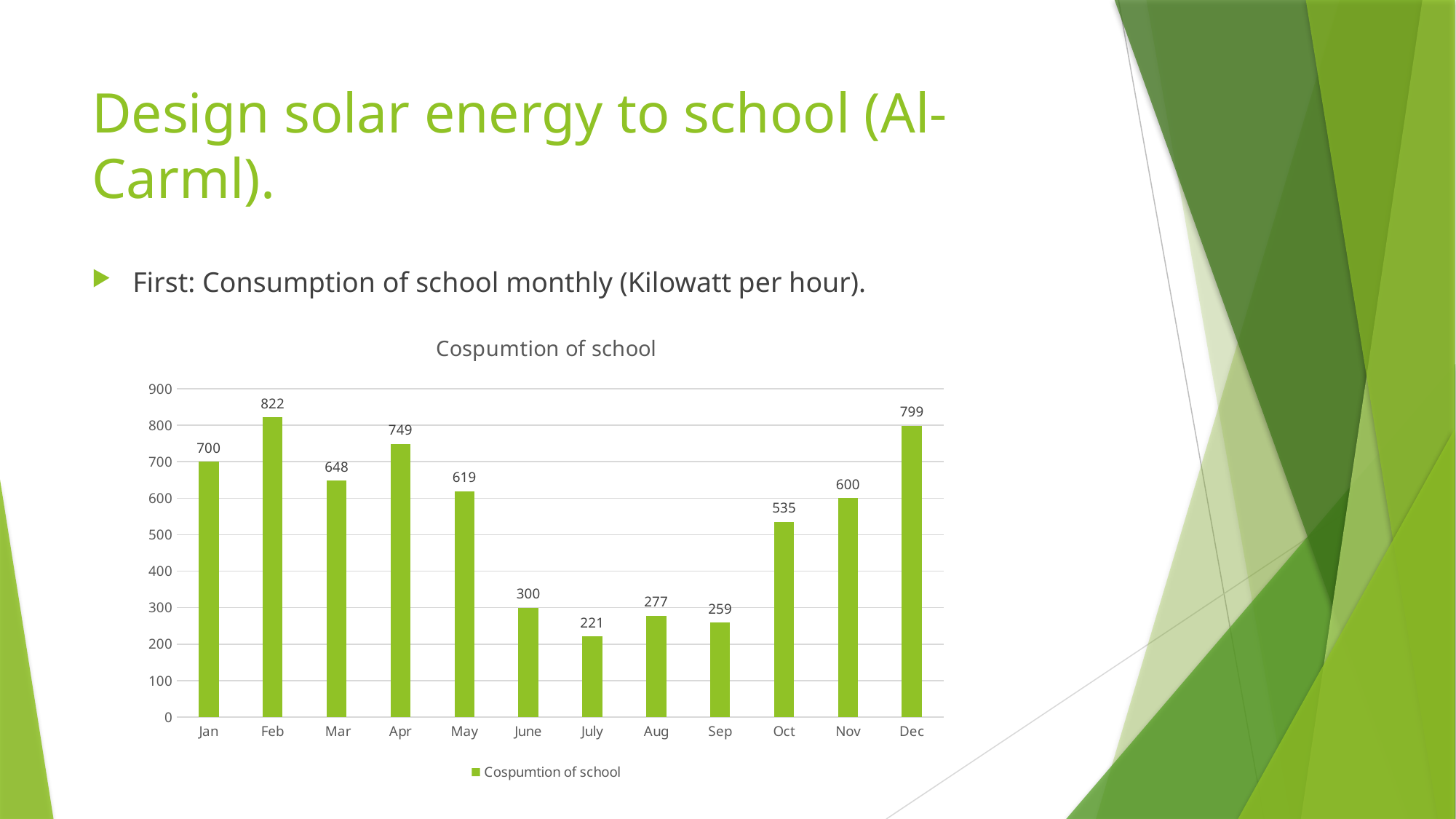
Which month has a higher consumption value, Apr or May? Apr What kind of chart is shown on the slide? Bar chart Which month has the highest consumption of school? Feb What is the consumption of school value for Oct? 535 What is the difference between the consumption values for Jan and June? 400 What is the title of the chart? Cospumtion of school What is the consumption of school value for Feb? 822 What is the consumption of school value for July? 221 How many months are shown on the x axis of the chart? 12 Is the value for Nov greater or less than 500? greater Which month has the lowest consumption of school? July What is the difference between the consumption values for Feb and Dec? 23